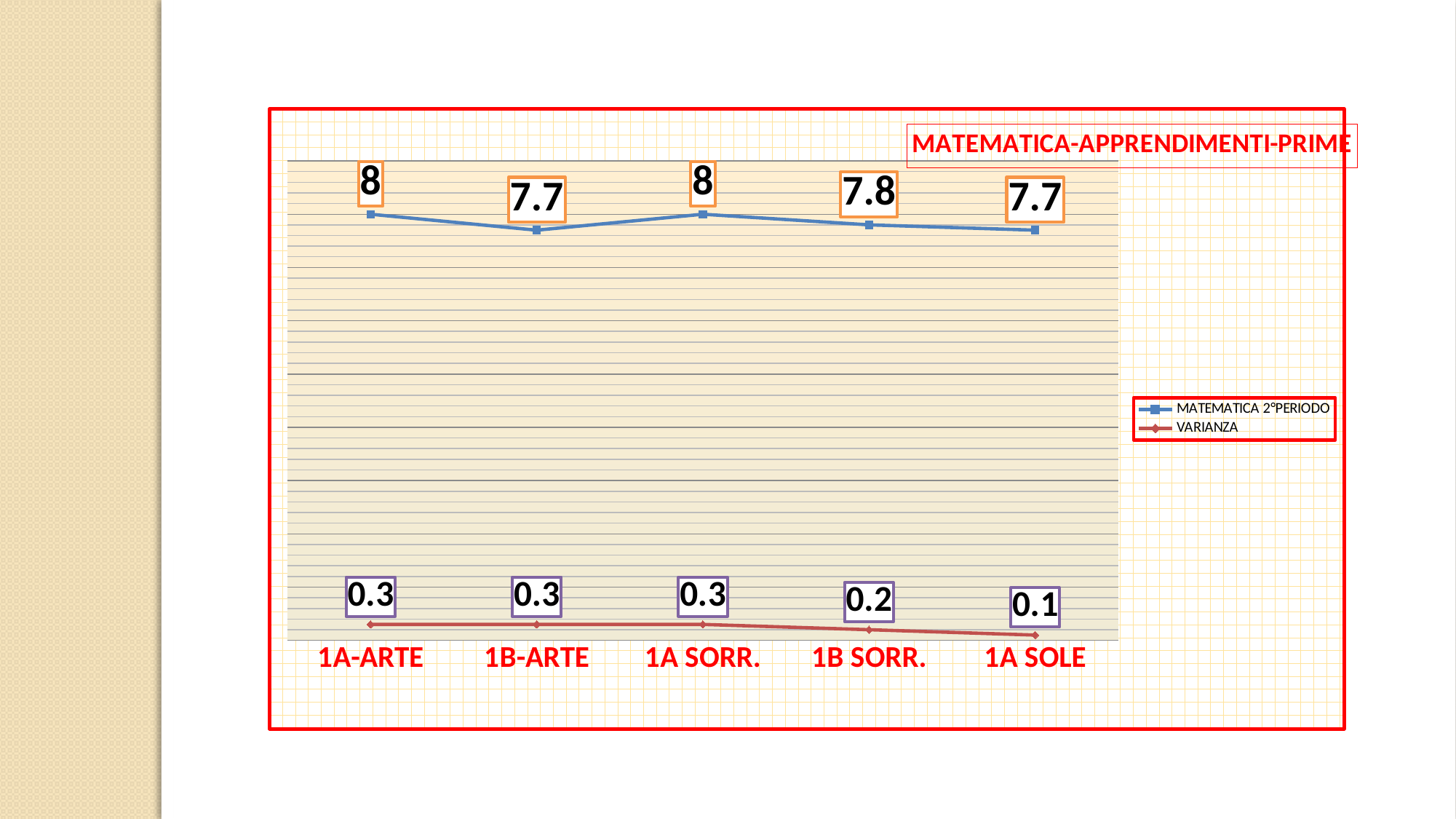
How many categories are shown on the x axis? 5 What is the MATEMATICA 2°PERIODO value for 1B SORR.? 7.8 What is the VARIANZA value for 1A SOLE? 0.1 What is the difference between the MATEMATICA 2°PERIODO values for 1A SORR. and 1B-ARTE? 0.3 Which is larger, the MATEMATICA 2°PERIODO value for 1A-ARTE or for 1B-ARTE? 1A-ARTE What is the difference between the VARIANZA values for 1A-ARTE and 1A SOLE? 0.2 What kind of chart is shown on the slide? Line chart What is the title of the chart? MATEMATICA-APPRENDIMENTI-PRIME Which category has the lowest VARIANZA value? 1A SOLE What is the VARIANZA value for 1B SORR.? 0.2 How many series does the legend list? 2 What is the MATEMATICA 2°PERIODO value for 1B-ARTE? 7.7